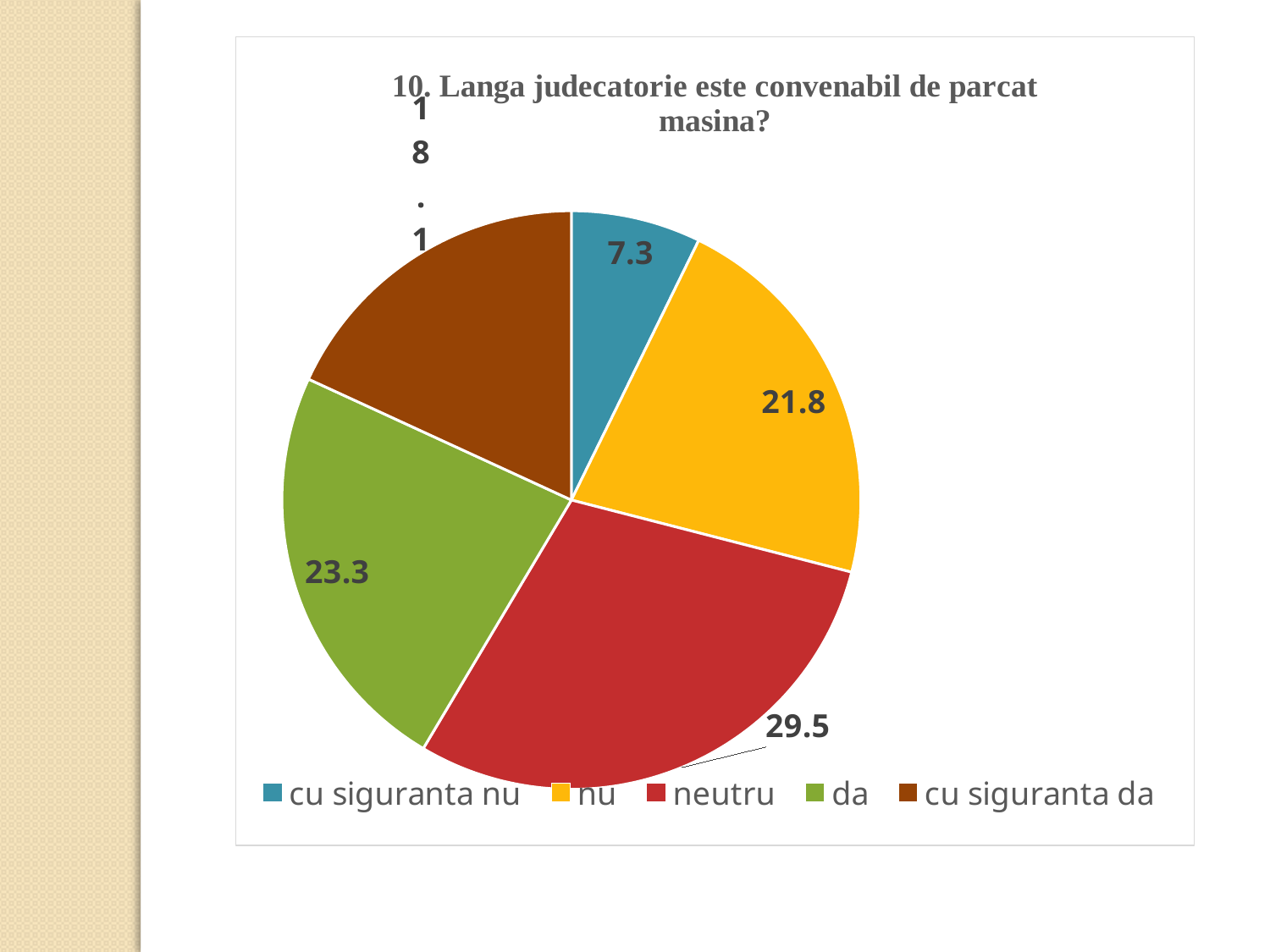
Which category has the smallest slice of the pie? cu siguranta nu Which is larger, the value for "da" or the value for "nu"? da What is the title of the chart? 10. Langa judecatorie este convenabil de parcat masina? What is the value for "neutru"? 29.5 What is the difference between the values for "neutru" and "nu"? 7.7 What is the value for "cu siguranta da"? 18.1 What is the value for "cu siguranta nu"? 7.3 What is the value for "da"? 23.3 What kind of chart is shown on the slide? pie chart Which category has the largest slice of the pie? neutru How many categories does the pie chart have? 5 What is the value for "nu"? 21.8